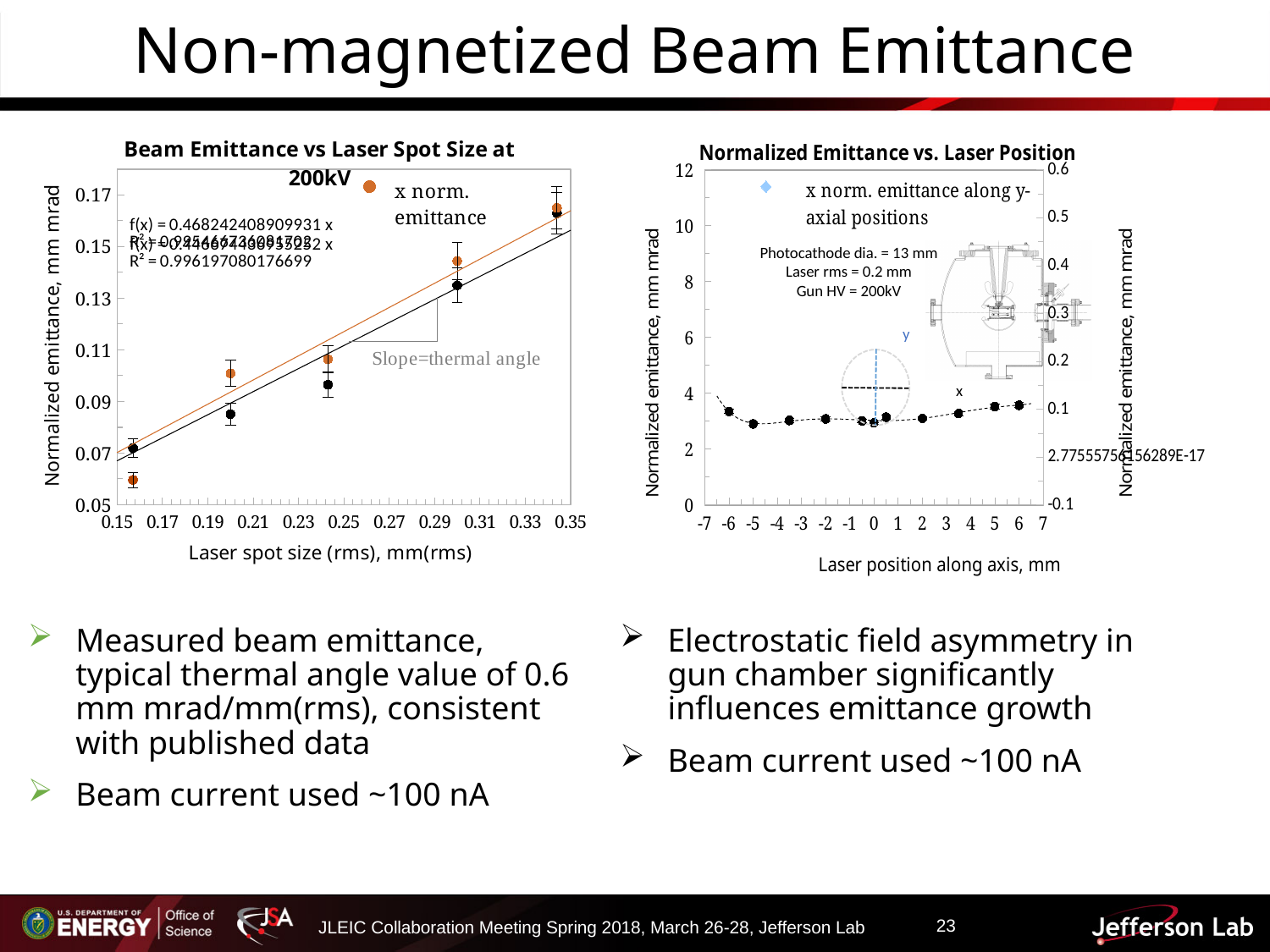
In the 'Beam Emittance vs Laser Spot Size at 200kV' chart, at a laser spot size of 0.20, which series has the larger value: the orange or the black points? Orange In the 'Beam Emittance vs Laser Spot Size at 200kV' chart, is the orange 'x norm. emittance' value at a laser spot size of 0.35 greater or less than 0.15? greater In the 'Beam Emittance vs Laser Spot Size at 200kV' chart, which is larger: the emittance at a laser spot size of 0.35 or at 0.15? 0.35 What kind of chart is the 'Beam Emittance vs Laser Spot Size at 200kV' chart? Scatter chart What is the x-axis label of the 'Beam Emittance vs Laser Spot Size at 200kV' chart? Laser spot size (rms), mm(rms) How many series does the legend of the 'Normalized Emittance vs. Laser Position' chart list? 1 In the 'Normalized Emittance vs. Laser Position' chart, is the emittance at a laser position of -5 mm greater or less than 4? less In the 'Beam Emittance vs Laser Spot Size at 200kV' chart, do the emittance values rise or fall as laser spot size increases? Rise In the 'Beam Emittance vs Laser Spot Size at 200kV' chart, is the orange 'x norm. emittance' value at a laser spot size of 0.15 greater or less than 0.07? less What is the legend entry in the 'Normalized Emittance vs. Laser Position' chart? x norm. emittance along y-axial positions What kind of chart is the 'Normalized Emittance vs. Laser Position' chart? Scatter chart